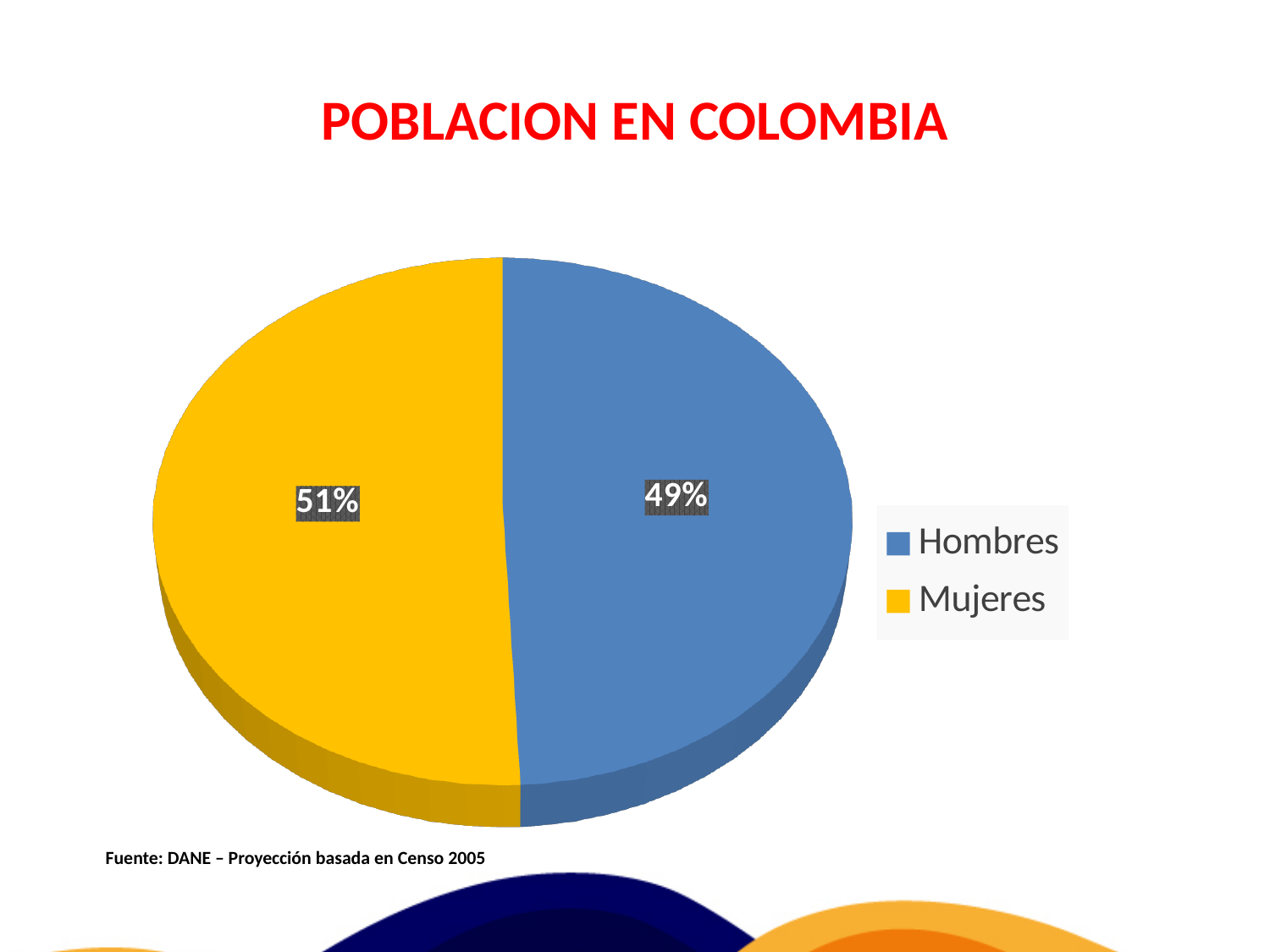
Which category has the larger share of the pie? Mujeres What is the title of the chart? POBLACION EN COLOMBIA What is the difference in percentage points between Mujeres and Hombres? 2 What kind of chart is shown on the slide? pie chart What percentage of the population is Hombres? 49% How many slices does the pie chart have? 2 What percentage of the population is Mujeres? 51% Is the share for Mujeres greater or less than 50%? greater Is the share for Hombres larger or smaller than the share for Mujeres? smaller How many entries does the legend list? 2 What colour represents Mujeres in the pie chart? yellow Which category has the smaller share of the pie? Hombres